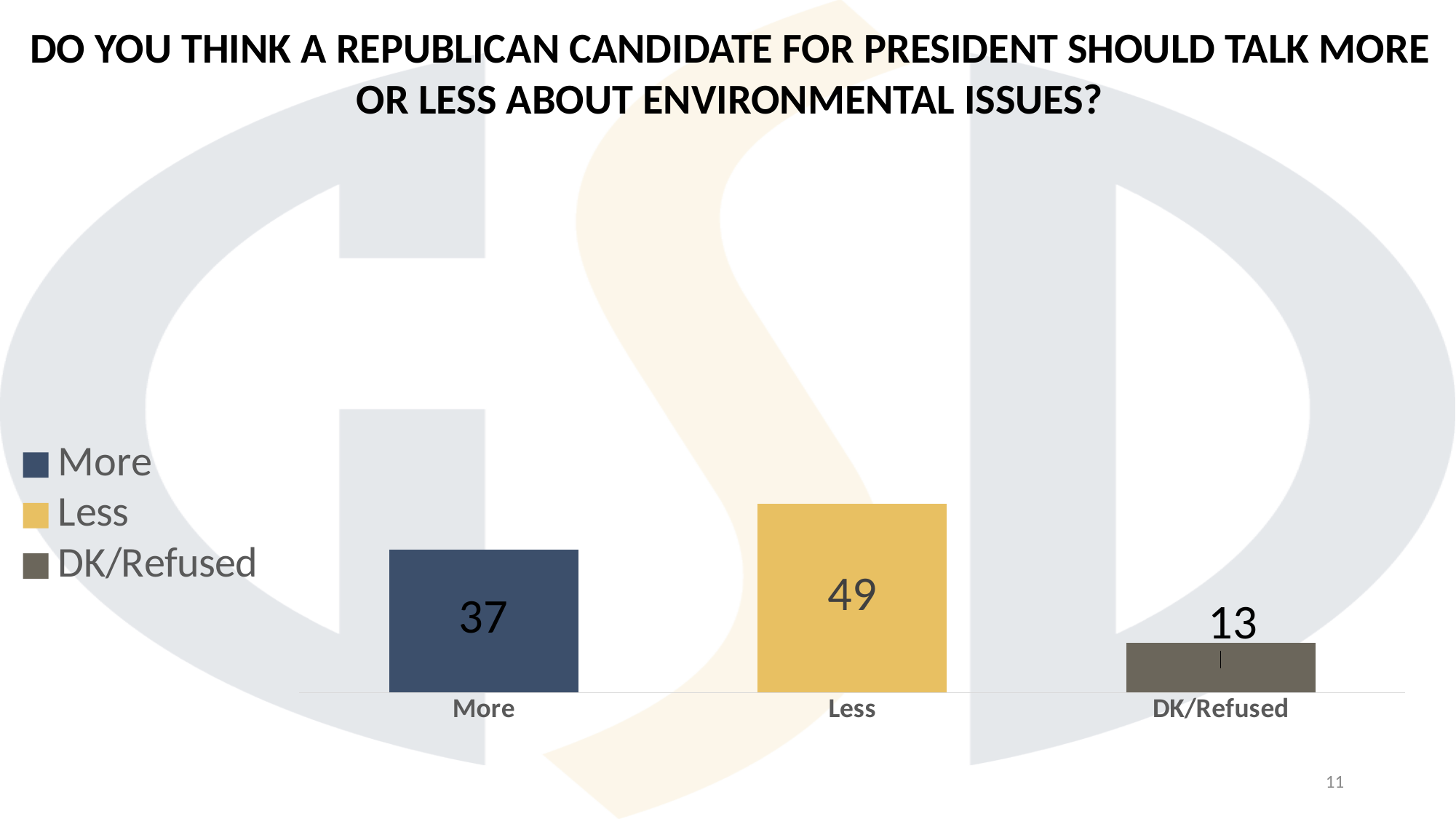
How many categories are shown on the x axis? 3 Which category has the highest value? Less Which category has the lowest value? DK/Refused What is the difference between the values for More and DK/Refused? 24 What is the difference between the values for Less and More? 12 What is the value for DK/Refused? 13 What kind of chart is shown on the slide? Bar chart How many entries does the legend list? 3 Which is larger, the value for More or the value for Less? Less What is the value for Less? 49 What is the value for More? 37 What colour is the bar for Less? Yellow